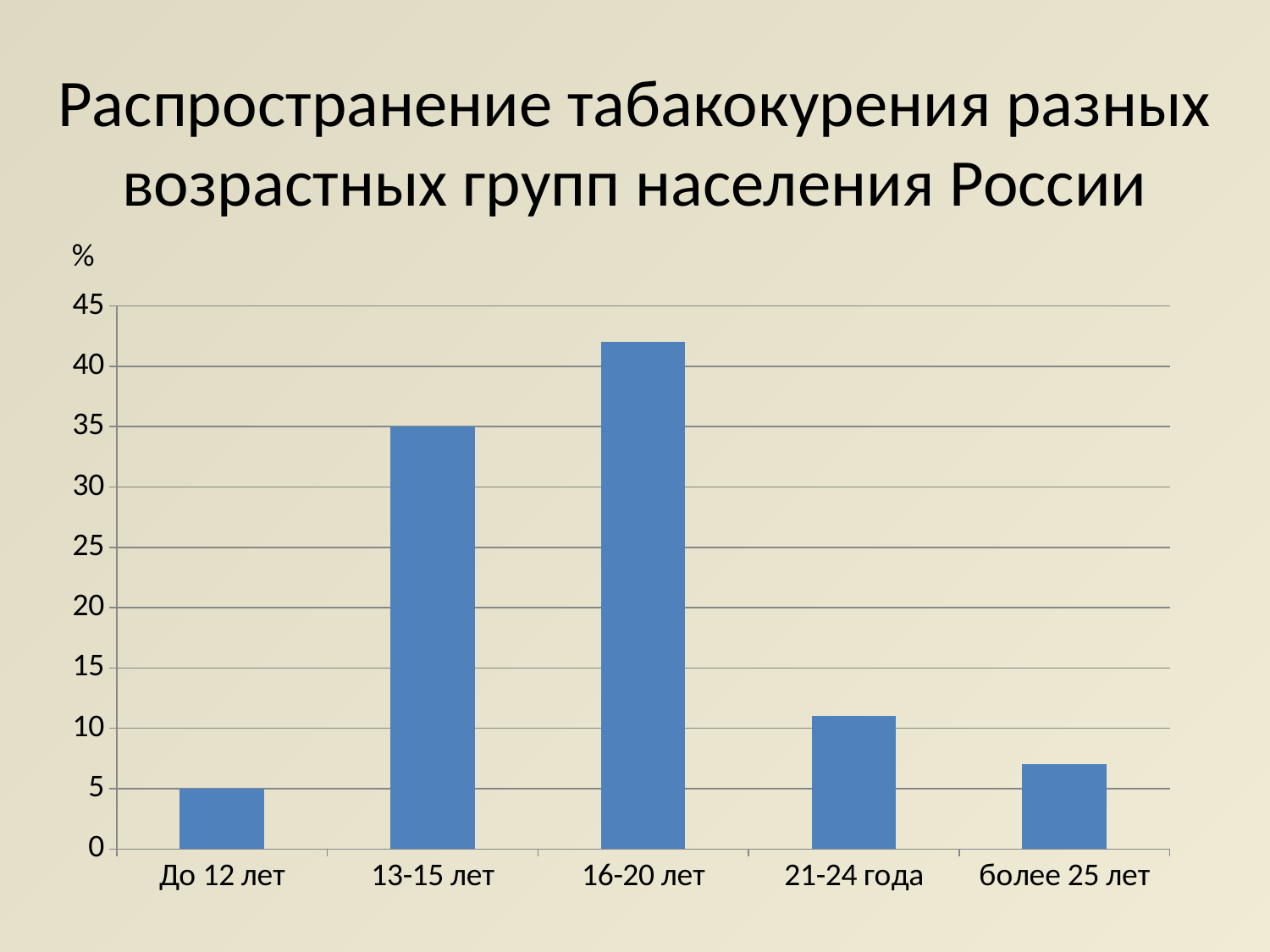
What kind of chart is shown on the slide? bar chart Is the value for 21-24 года greater or less than 15? less Which age group has the highest value in the chart? 16-20 лет Is the value for 16-20 лет greater or less than 40? greater Which is larger, the value for 21-24 года or the value for более 25 лет? 21-24 года Which age group has the lowest value in the chart? До 12 лет Is the value for более 25 лет greater or less than 5? greater What is the value for the До 12 лет group? 5 What is the difference between the values for 13-15 лет and До 12 лет? 30 What unit is indicated on the vertical axis of the chart? % How many age groups are shown on the x axis of the chart? 5 What is the value for the 13-15 лет group? 35